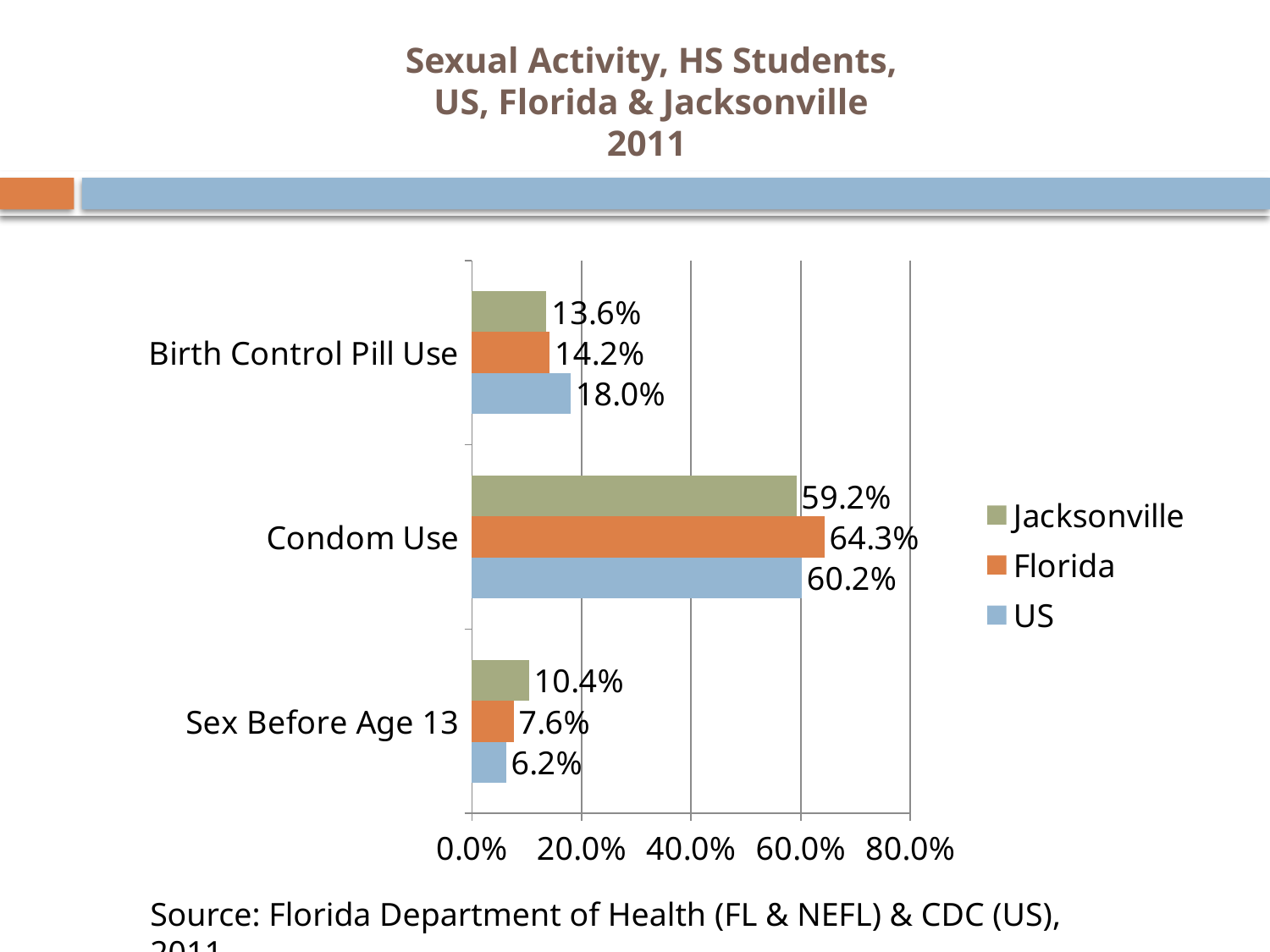
What is the difference between the US and Jacksonville values for Birth Control Pill Use? 4.4% Which colour represents Florida in the legend? Orange Is the Jacksonville value for Condom Use greater or less than 40.0%? greater What kind of chart is shown on the slide? Bar chart How many categories are shown on the chart? 3 What is the US value for Birth Control Pill Use? 18.0% What is the Jacksonville value for Sex Before Age 13? 10.4% Which region has the lowest value for Sex Before Age 13? US How many series does the legend list? 3 What is the Florida value for Condom Use? 64.3% Which region has the highest value for Condom Use? Florida Which is larger for Sex Before Age 13: the Florida value or the Jacksonville value? Jacksonville